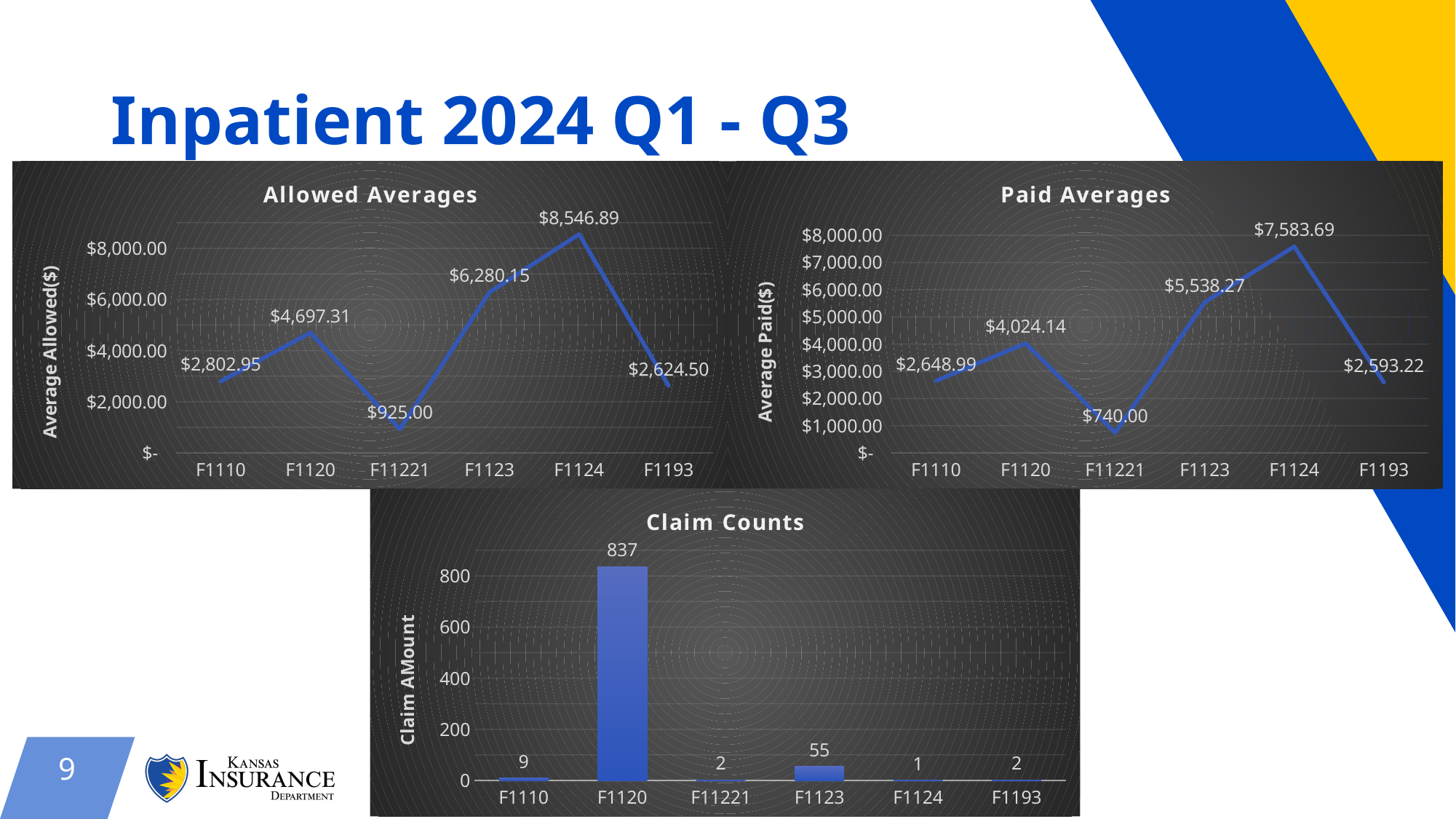
In the Paid Averages chart, what is the difference between the values for F1120 and F1110? $1,375.15 In the Paid Averages chart, which category has the highest value? F1124 In the Claim Counts chart, what is the difference between the values for F1120 and F1123? 782 In the Claim Counts chart, what is the value for F1123? 55 In the Allowed Averages chart, is the value for F1120 larger or smaller than the value for F1193? larger What kind of chart is the Claim Counts chart? bar chart What kind of chart is the Allowed Averages chart? line chart In the Allowed Averages chart, what is the value for F1124? $8,546.89 In the Claim Counts chart, which category has the highest value? F1120 How many categories are shown on the x axis of the Paid Averages chart? 6 In the Paid Averages chart, what is the value for F1123? $5,538.27 In the Allowed Averages chart, which category has the lowest value? F11221